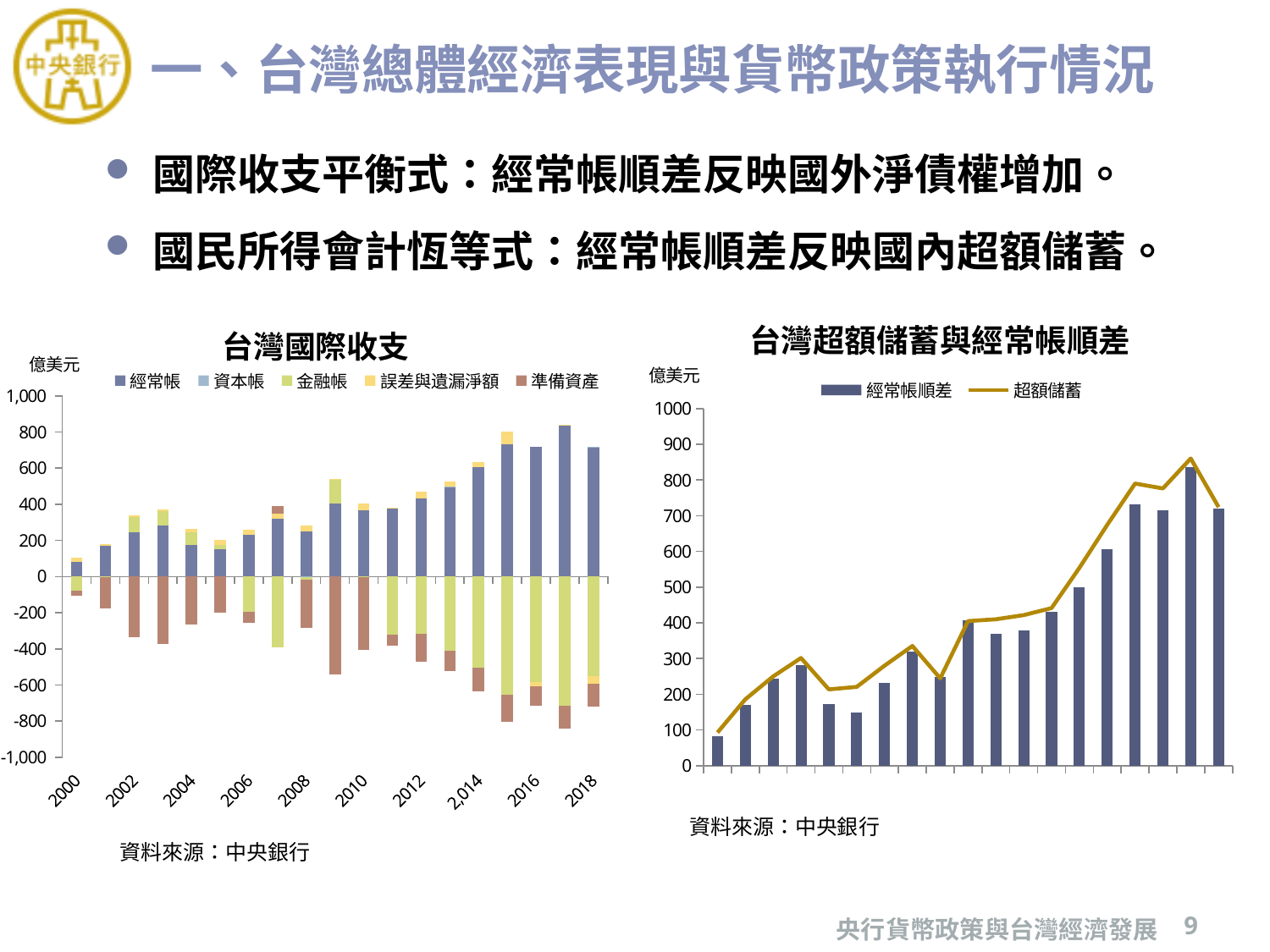
In the 台灣國際收支 chart, is the 準備資產 value for 2009 greater or less than -400? less In the 台灣國際收支 chart, which year has the highest 經常帳 value? 2017 In the 台灣國際收支 chart, is the 經常帳 value for 2000 greater or less than 100? less In the 台灣國際收支 chart, is the 經常帳 value for 2017 greater or less than 800? greater In the 台灣超額儲蓄與經常帳順差 chart, which series is drawn as a line? 超額儲蓄 How many series does the legend of the 台灣超額儲蓄與經常帳順差 chart list? 2 In the 台灣國際收支 chart, does the 經常帳 series generally rise or fall from 2000 to 2018? rise What unit is shown on the y axis of the 台灣國際收支 chart? 億美元 How many series does the legend of the 台灣國際收支 chart list? 5 What kind of chart is the 台灣國際收支 chart on the left? stacked bar chart How many years are plotted on the x axis of the 台灣國際收支 chart? 19